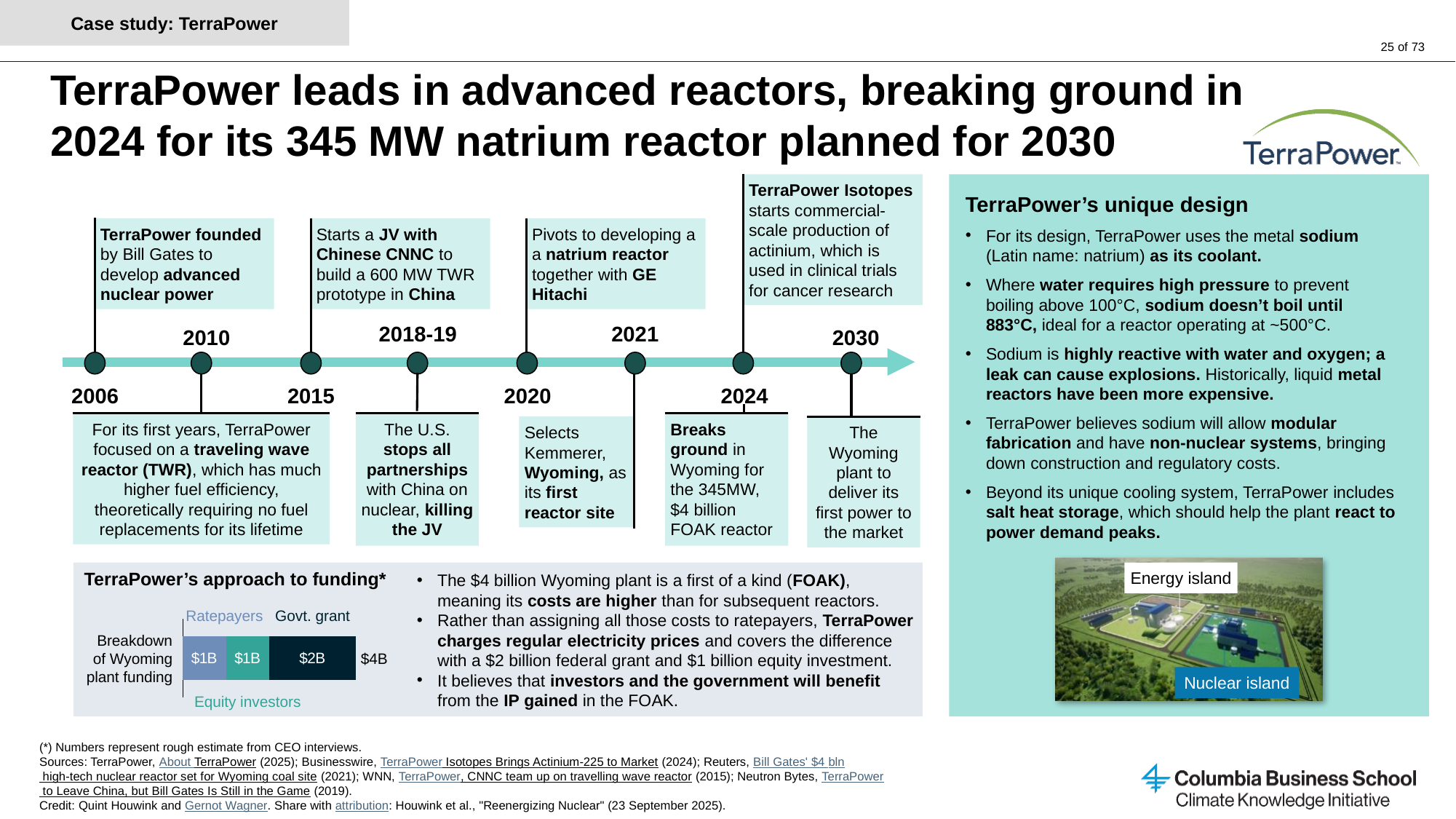
In the 'Breakdown of Wyoming plant funding' bar, what is the difference between the Govt. grant and the Ratepayers segments? $1B In the 'Breakdown of Wyoming plant funding' bar, what share of the total funding comes from the Govt. grant? 50% In the 'Breakdown of Wyoming plant funding' bar, which segment is labelled below the bar? Equity investors What is the title of the box containing the 'Breakdown of Wyoming plant funding' chart? TerraPower's approach to funding* In the 'Breakdown of Wyoming plant funding' bar, which is larger: the Govt. grant segment or the Equity investors segment? Govt. grant In the 'Breakdown of Wyoming plant funding' bar, what is the total of the stacked bar? $4B In the 'Breakdown of Wyoming plant funding' bar, what is the value for Ratepayers? $1B In the 'Breakdown of Wyoming plant funding' bar, which funding source contributes the largest amount? Govt. grant In the 'Breakdown of Wyoming plant funding' bar, what is the value for Govt. grant? $2B In the 'Breakdown of Wyoming plant funding' bar, what is the value for Equity investors? $1B How many funding segments make up the 'Breakdown of Wyoming plant funding' bar? 3 What kind of chart is used to show the 'Breakdown of Wyoming plant funding'? Stacked bar chart